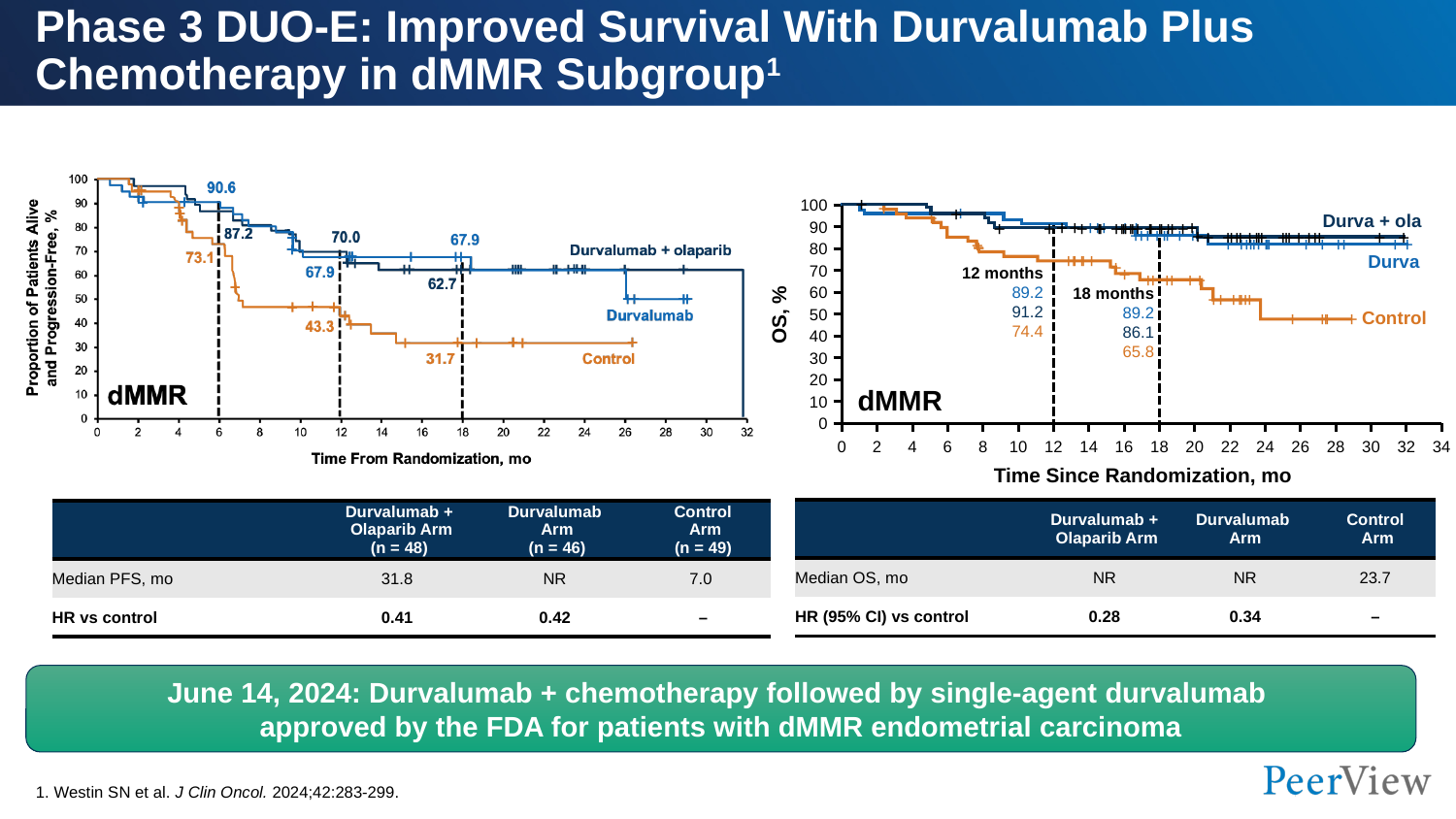
In the right chart (OS, %), what is the 18-month value for the Durva arm? 86.1 In the right chart (OS, %), what is the difference between the 18-month values for Durva + ola and Control? 23.4 What is the x-axis title of the right chart (OS, %)? Time Since Randomization, mo What type of chart is shown on the left side of the slide? Line chart (Kaplan-Meier survival curve) In the left chart (progression-free survival), what is the labeled value for the Durvalumab + olaparib curve at 6 months? 90.6 In the left chart (progression-free survival), what is the labeled value for the Control curve at 18 months? 31.7 How many treatment arms are plotted in the right chart (OS, %)? 3 In the right chart (OS, %), what is the 12-month value for the Control arm? 74.4 In the right chart (OS, %), at 12 months, which arm has the higher value: Durva + ola or Durva? Durva In the left chart (progression-free survival), what is the difference between the 12-month values for Durvalumab + olaparib and Control? 26.7 In the left chart (progression-free survival), what is the labeled value for the Durvalumab curve at 12 months? 67.9 In the left chart (progression-free survival), which curve has the lowest labeled value at 18 months? Control